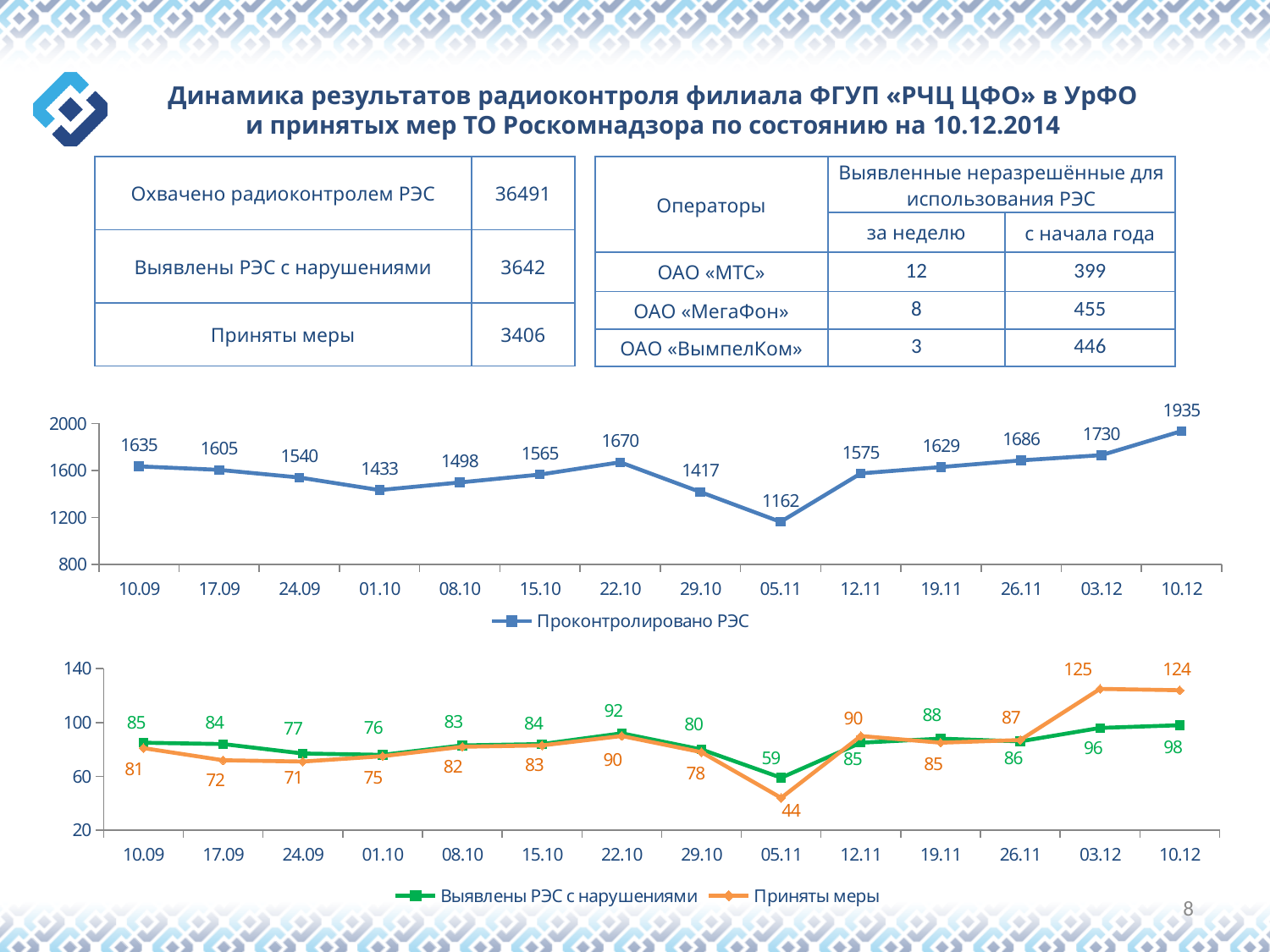
In the upper chart (Проконтролировано РЭС), what is the value for 10.12? 1935 In the upper chart (Проконтролировано РЭС), which date has the lowest value? 05.11 What type of chart is the upper chart? Line chart In the lower chart, what is the value of Приняты меры for 03.12? 125 In the lower chart, which is larger for 10.12: Выявлены РЭС с нарушениями or Приняты меры? Приняты меры In the upper chart (Проконтролировано РЭС), which date has the highest value? 10.12 In the upper chart (Проконтролировано РЭС), how many data points are plotted? 14 In the upper chart (Проконтролировано РЭС), what is the difference between the values for 10.12 and 03.12? 205 How many series does the legend of the lower chart list? 2 In the upper chart (Проконтролировано РЭС), what is the value for 05.11? 1162 In the lower chart, which date has the lowest value for Приняты меры? 05.11 In the lower chart, what is the value of Выявлены РЭС с нарушениями for 22.10? 92